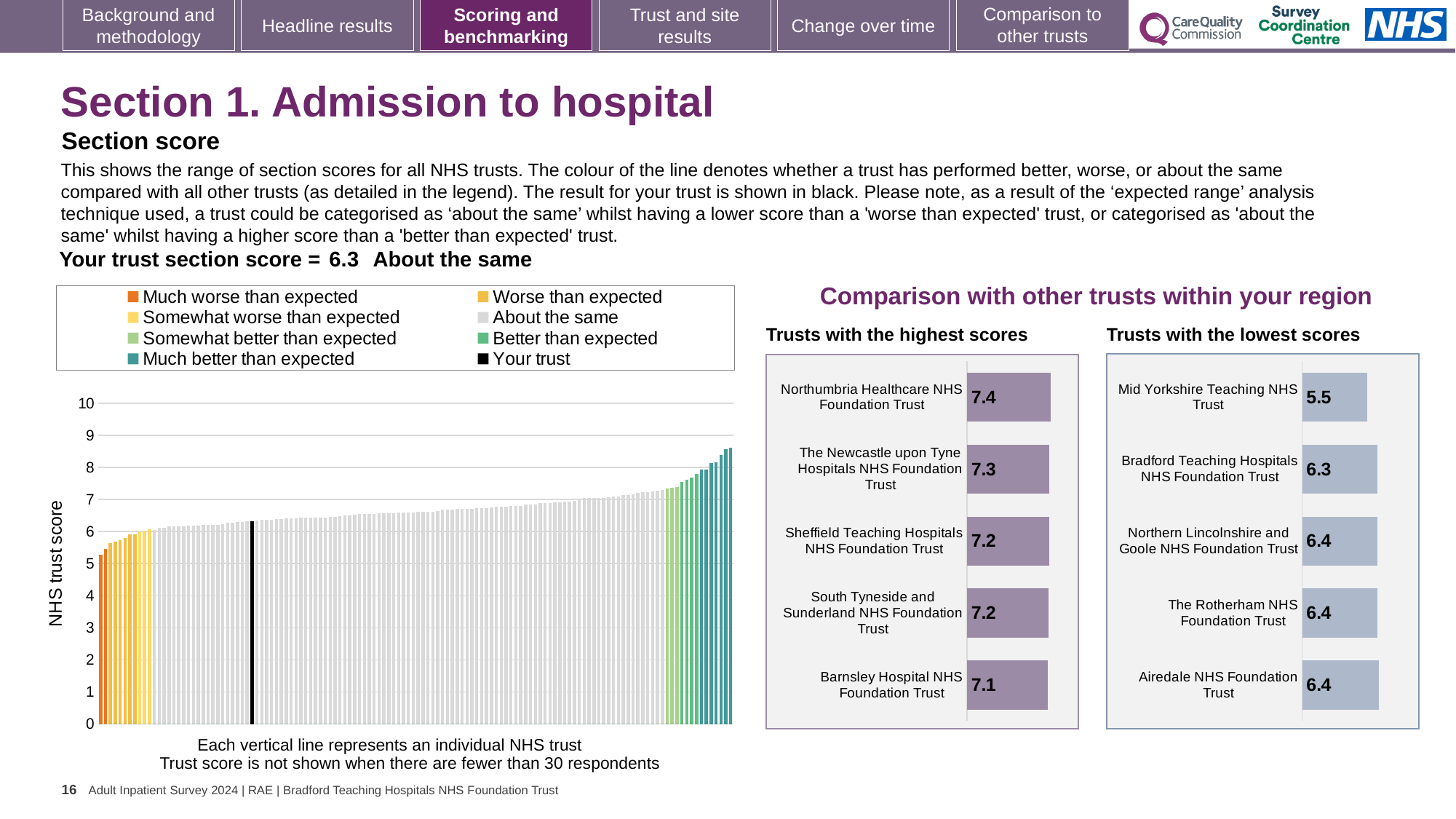
In the 'Trusts with the lowest scores' chart, what is the difference between the scores of Bradford Teaching Hospitals NHS Foundation Trust and Mid Yorkshire Teaching NHS Trust? 0.8 In the 'Trusts with the lowest scores' chart, how many trusts are shown? 5 In the 'Trusts with the highest scores' chart, what is the difference between the scores of Northumbria Healthcare NHS Foundation Trust and Barnsley Hospital NHS Foundation Trust? 0.3 In the 'Trusts with the lowest scores' chart, which trust has the lowest score? Mid Yorkshire Teaching NHS Trust In the large 'NHS trust score' chart on the left, do the bar values rise or fall from left to right along the x axis? Rise What kind of chart is the large 'NHS trust score' chart on the left of the slide? Bar chart In the 'Trusts with the lowest scores' chart, what is the score for Bradford Teaching Hospitals NHS Foundation Trust? 6.3 In the 'Trusts with the highest scores' chart, what is the score for Northumbria Healthcare NHS Foundation Trust? 7.4 In the 'Trusts with the highest scores' chart, which trust has the highest score? Northumbria Healthcare NHS Foundation Trust How many entries does the legend of the large 'NHS trust score' chart on the left list? 8 In the 'Trusts with the highest scores' chart, what is the score for Barnsley Hospital NHS Foundation Trust? 7.1 In the 'Trusts with the lowest scores' chart, what is the score for Mid Yorkshire Teaching NHS Trust? 5.5